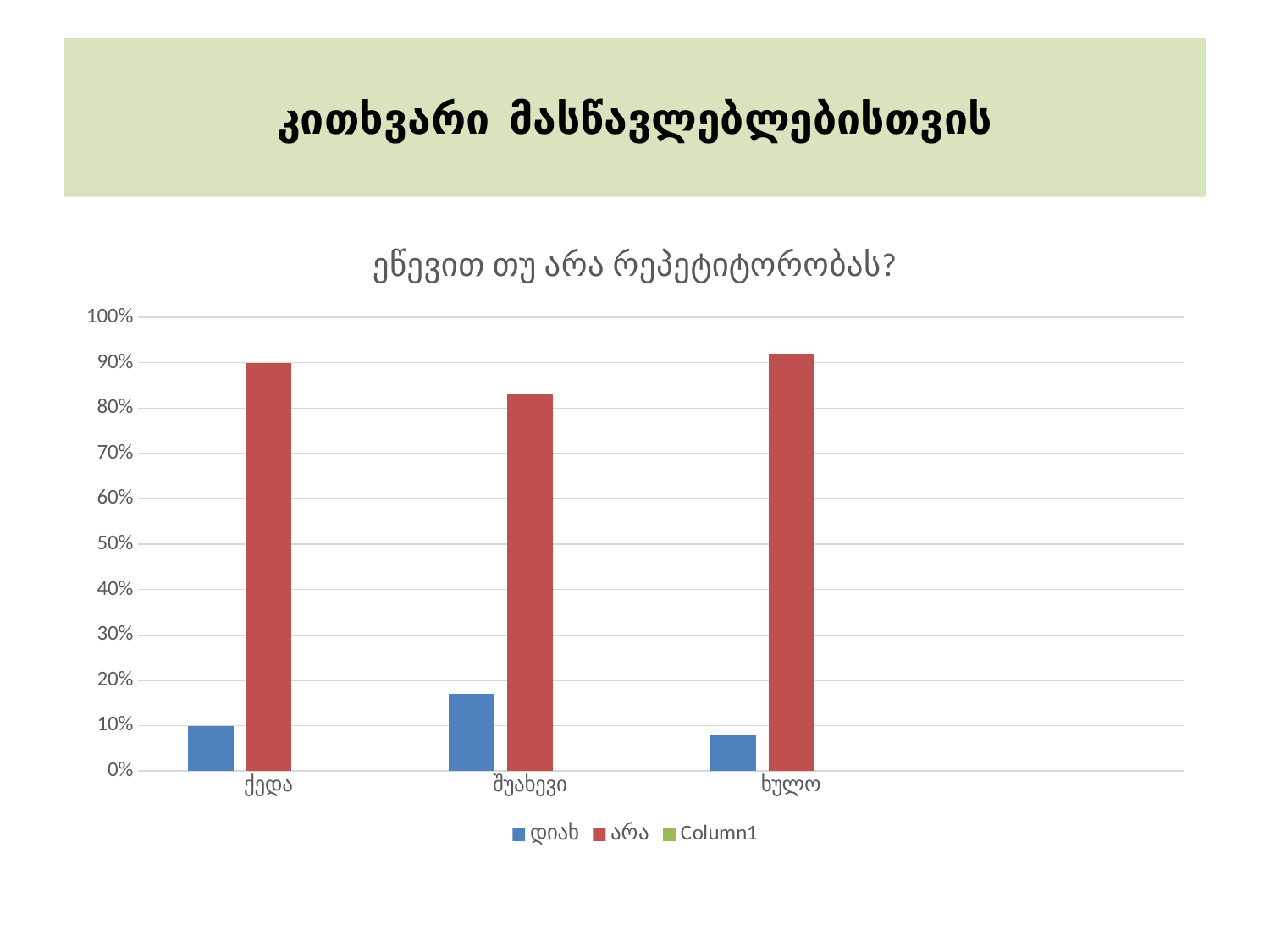
Which colour represents the series 'არა' in the chart? red What is the value of 'არა' for ქედა? 90% Is the value of 'დიახ' for ხულო greater or less than 10%? less Is the value of 'არა' for შუახევი greater or less than 80%? greater For ხულო, which is larger: 'დიახ' or 'არა'? არა What is the value of 'დიახ' for ქედა? 10% Which category has the highest value for 'დიახ'? შუახევი What is the title of the chart? ეწევით თუ არა რეპეტიტორობას? Is the value of 'დიახ' for შუახევი greater or less than 10%? greater How many series does the chart's legend list? 3 What kind of chart is shown on the slide? bar chart How many categories are shown on the x axis of the chart? 3